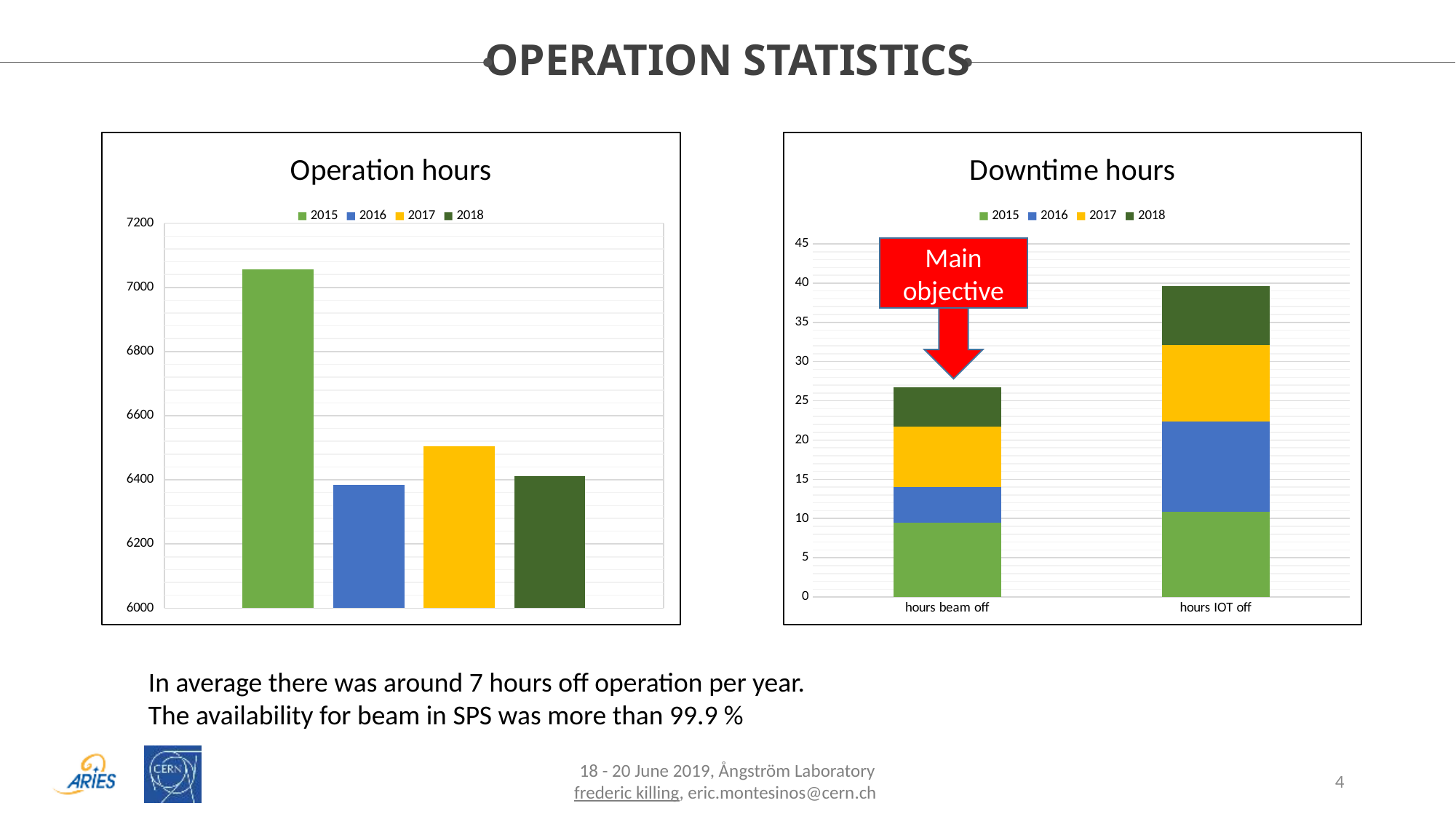
In the "Operation hours" chart, is the value for 2017 greater or less than 6600? less In the "Operation hours" chart, is the value for 2016 greater or less than 6400? less In the "Downtime hours" chart, is the total for "hours beam off" greater or less than 30? less In the "Downtime hours" chart, which category has the taller stacked bar? hours IOT off In the "Downtime hours" chart, which category does the red "Main objective" arrow point to? hours beam off How many series does the legend of the "Operation hours" chart list? 4 In the "Operation hours" chart, which is larger, the value for 2017 or the value for 2016? 2017 In the "Operation hours" chart, which year has the highest value? 2015 What kind of chart is the "Downtime hours" chart? stacked bar chart What kind of chart is the "Operation hours" chart? bar chart How many categories are shown on the x axis of the "Downtime hours" chart? 2